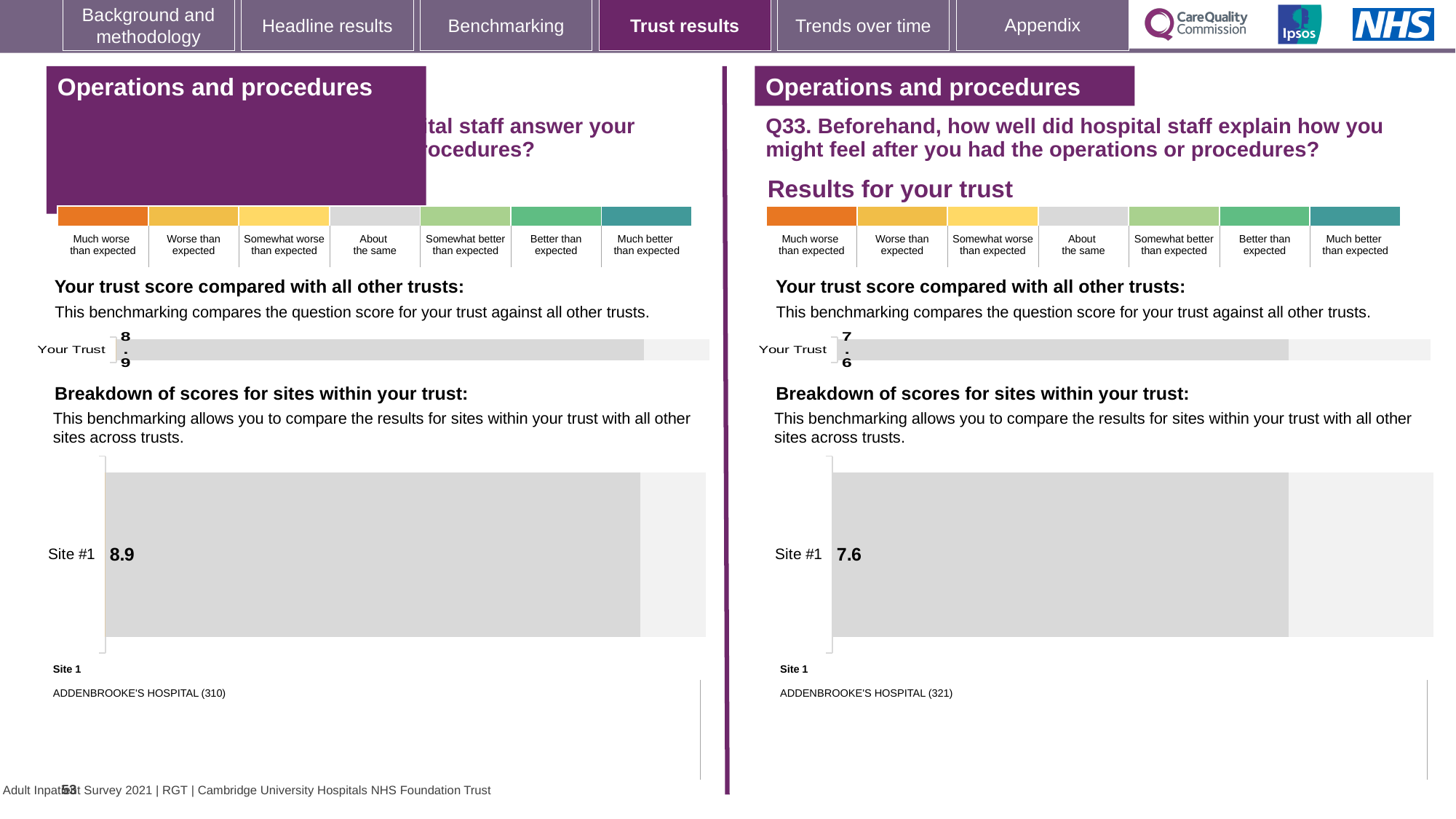
How many sites are shown in the right-hand 'Breakdown of scores for sites within your trust' chart? 1 Which hospital is listed as Site 1 beneath the right-hand site breakdown chart? ADDENBROOKE'S HOSPITAL (321) How many sites are shown in the left-hand 'Breakdown of scores for sites within your trust' chart? 1 In the left-hand 'Breakdown of scores for sites within your trust' chart, what is the score for Site #1? 8.9 Which hospital is listed as Site 1 beneath the left-hand site breakdown chart? ADDENBROOKE'S HOSPITAL (310) What type of chart is used to show the Site #1 score on the right half of the slide? Bar chart In the right-hand 'Breakdown of scores for sites within your trust' chart (Q33), what is the score for Site #1? 7.6 Which is larger: the Your Trust score on the left half of the slide or the Your Trust score on the right half (Q33)? Left half (8.9) On the left half of the slide, what is the score shown for Your Trust in the 'Your trust score compared with all other trusts' chart? 8.9 Is the Site #1 score in the right-hand site breakdown chart (Q33) greater or less than 8? less On the right half of the slide (Q33), what is the score shown for Your Trust in the 'Your trust score compared with all other trusts' chart? 7.6 What is the difference between the Site #1 score in the left-hand site breakdown chart and the Site #1 score in the right-hand site breakdown chart? 1.3